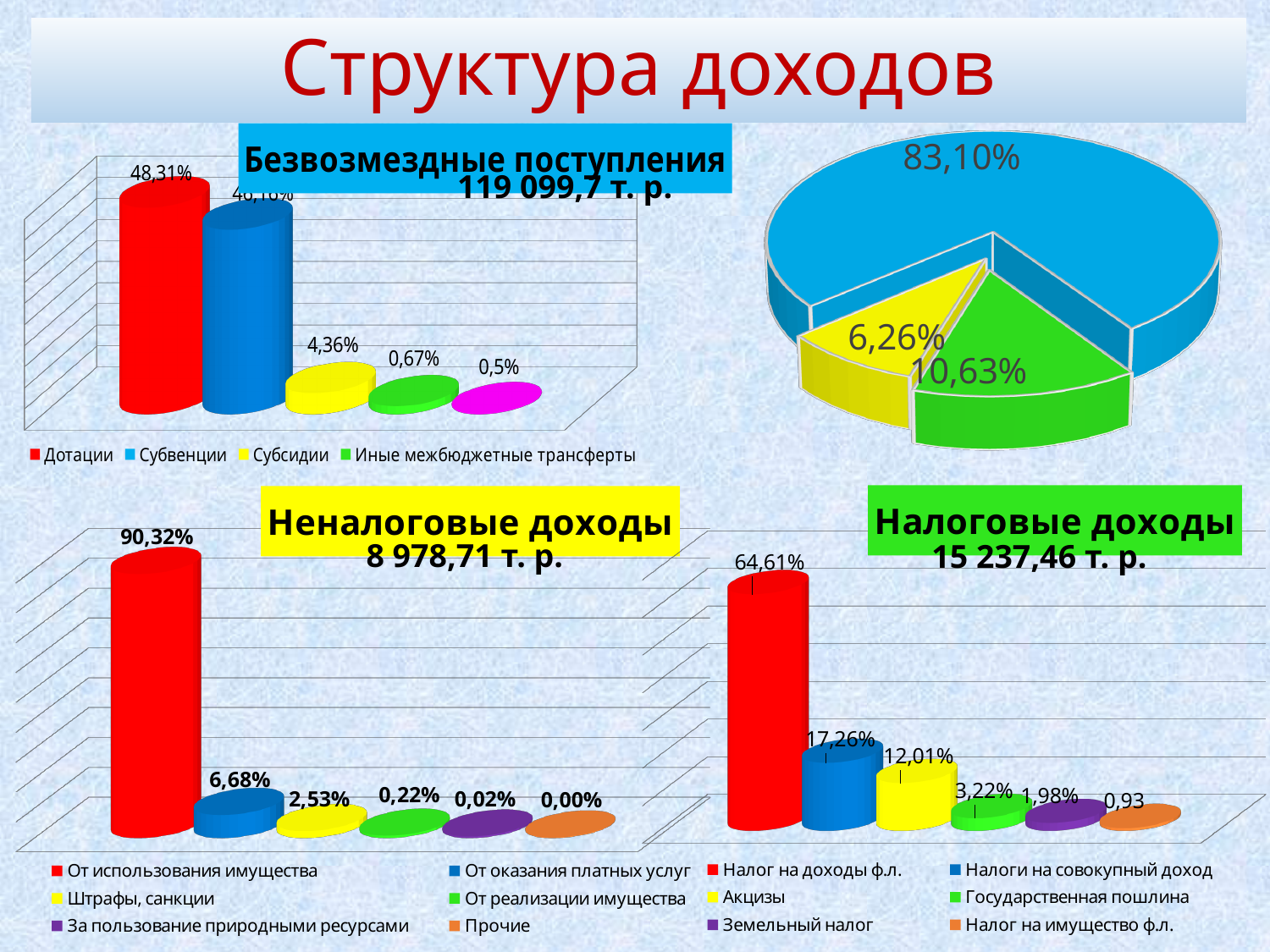
In the 'Неналоговые доходы' chart, what is the value for 'От использования имущества'? 90,32% In the 'Неналоговые доходы' chart, which is larger: 'От оказания платных услуг' or 'Штрафы, санкции'? От оказания платных услуг In the 'Налоговые доходы' chart, what is the value for 'Налог на доходы ф.л.'? 64,61% In the 'Налоговые доходы' chart, which category has the lowest value? Налог на имущество ф.л. In the 'Неналоговые доходы' chart, what is the value for 'Штрафы, санкции'? 2,53% In the 'Безвозмездные поступления' chart, which category has the highest value? Дотации In the 'Безвозмездные поступления' chart, what is the value for 'Субсидии'? 4,36% How many series does the legend of the 'Налоговые доходы' chart list? 6 What kind of chart is shown at the top right of the slide? Pie chart In the 'Налоговые доходы' chart, what is the difference between 'Налоги на совокупный доход' and 'Акцизы'? 5,25% In the 'Налоговые доходы' chart, what is the value for 'Акцизы'? 12,01% What is the value of the largest slice in the pie chart at the top right of the slide? 83,10%